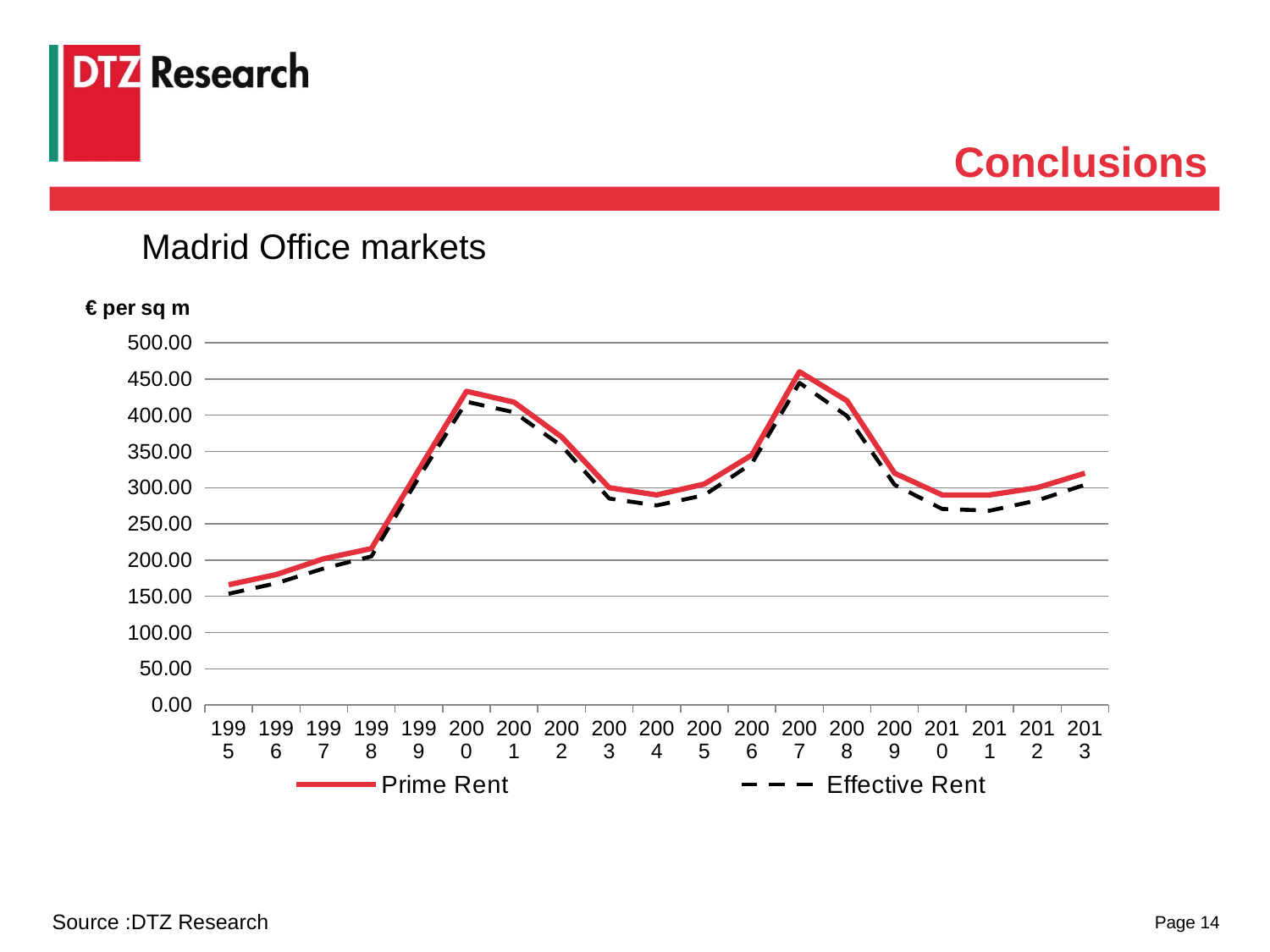
How many series does the legend list? 2 What unit is shown on the y axis label? € per sq m Is the value for Prime Rent in 1998 greater or less than 200? greater Does Prime Rent rise or fall between 2007 and 2010? Fall Is the value for Prime Rent in 2007 greater or less than 400? greater Is the value for Effective Rent in 2010 greater or less than 300? less In which year is Prime Rent at its lowest value? 1995 What kind of chart is shown on the slide? Line chart What is the title of the chart? Madrid Office markets In which year does Prime Rent reach its highest value? 2007 Which series is higher in 2008, Prime Rent or Effective Rent? Prime Rent How many years are plotted along the x axis? 19